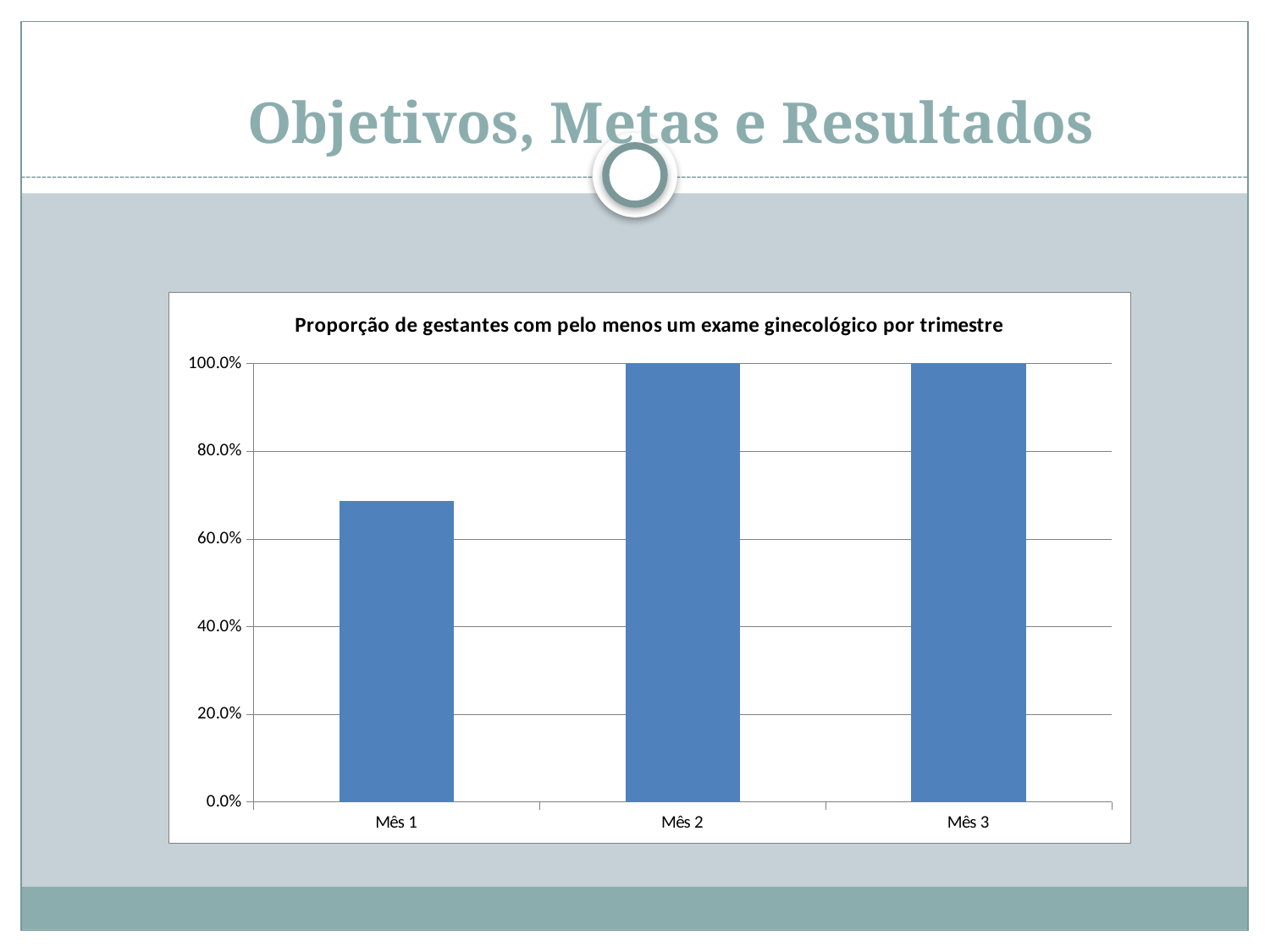
What is the title of the chart? Proporção de gestantes com pelo menos um exame ginecológico por trimestre Which category has the lowest value? Mês 1 Which is larger, the value for Mês 1 or the value for Mês 2? Mês 2 What colour are the bars in the chart? blue Is the value for Mês 1 greater or less than 80.0%? less What kind of chart is shown on the slide? bar chart How many categories are shown on the x axis of the chart? 3 Which is larger, the value for Mês 3 or the value for Mês 1? Mês 3 What is the value for Mês 2? 100.0% What is the value for Mês 3? 100.0% Is the value for Mês 1 greater or less than 60.0%? greater Do the values rise or fall from Mês 1 to Mês 2? rise